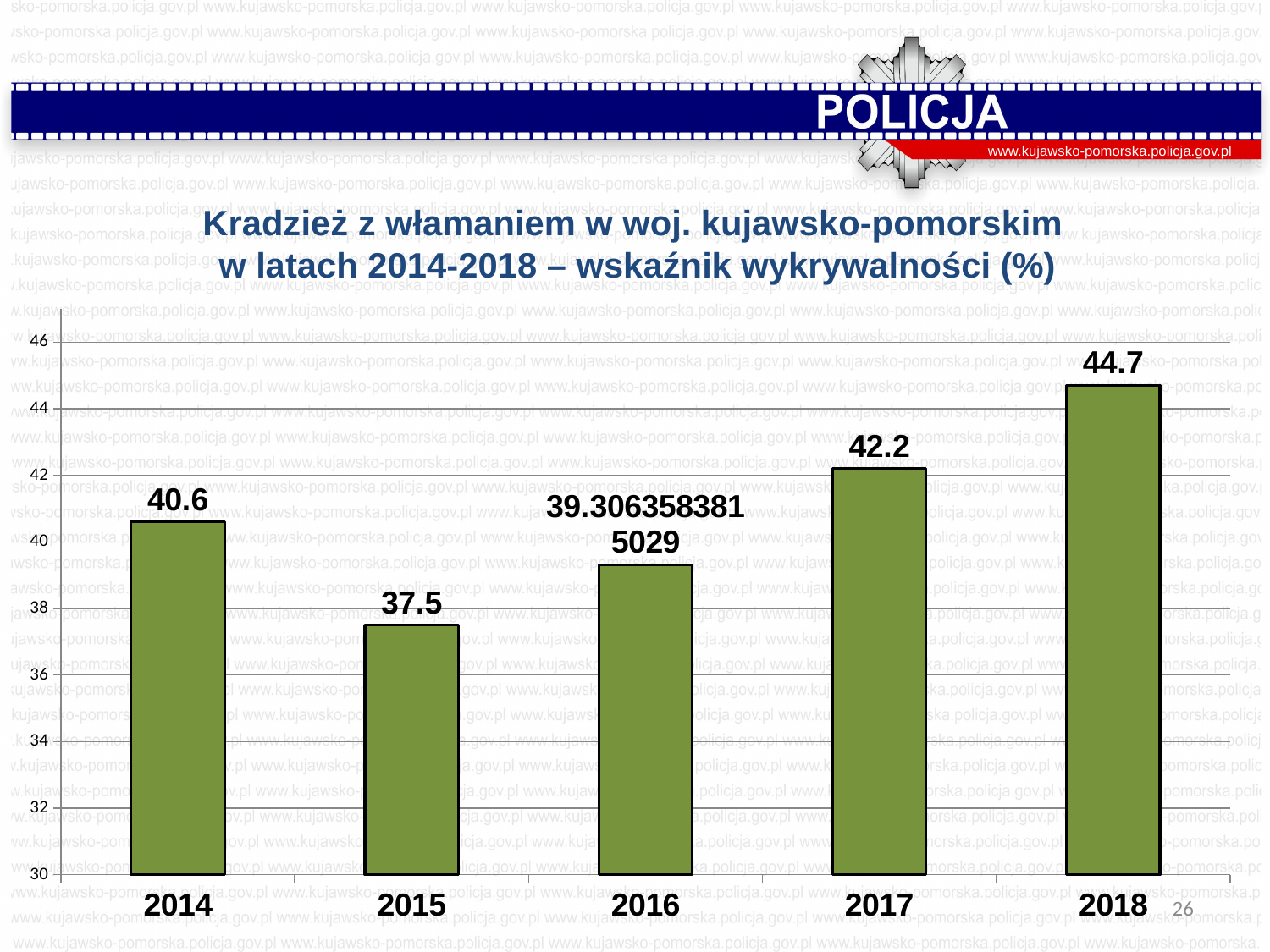
Which year has a higher detection rate, 2014 or 2017? 2017 Which year has the highest detection rate? 2018 What is the detection rate for 2018? 44.7 Is the value for 2016 greater or less than 40? less What is the difference between the detection rate in 2018 and in 2014? 4.1 How many years are shown on the x axis of the chart? 5 What is the detection rate (wskaźnik wykrywalności) for 2014? 40.6 What type of chart is shown on the slide? bar chart What is the difference between the detection rate in 2017 and in 2015? 4.7 What is the detection rate for 2015? 37.5 Which year has the lowest detection rate? 2015 What is the detection rate for 2017? 42.2